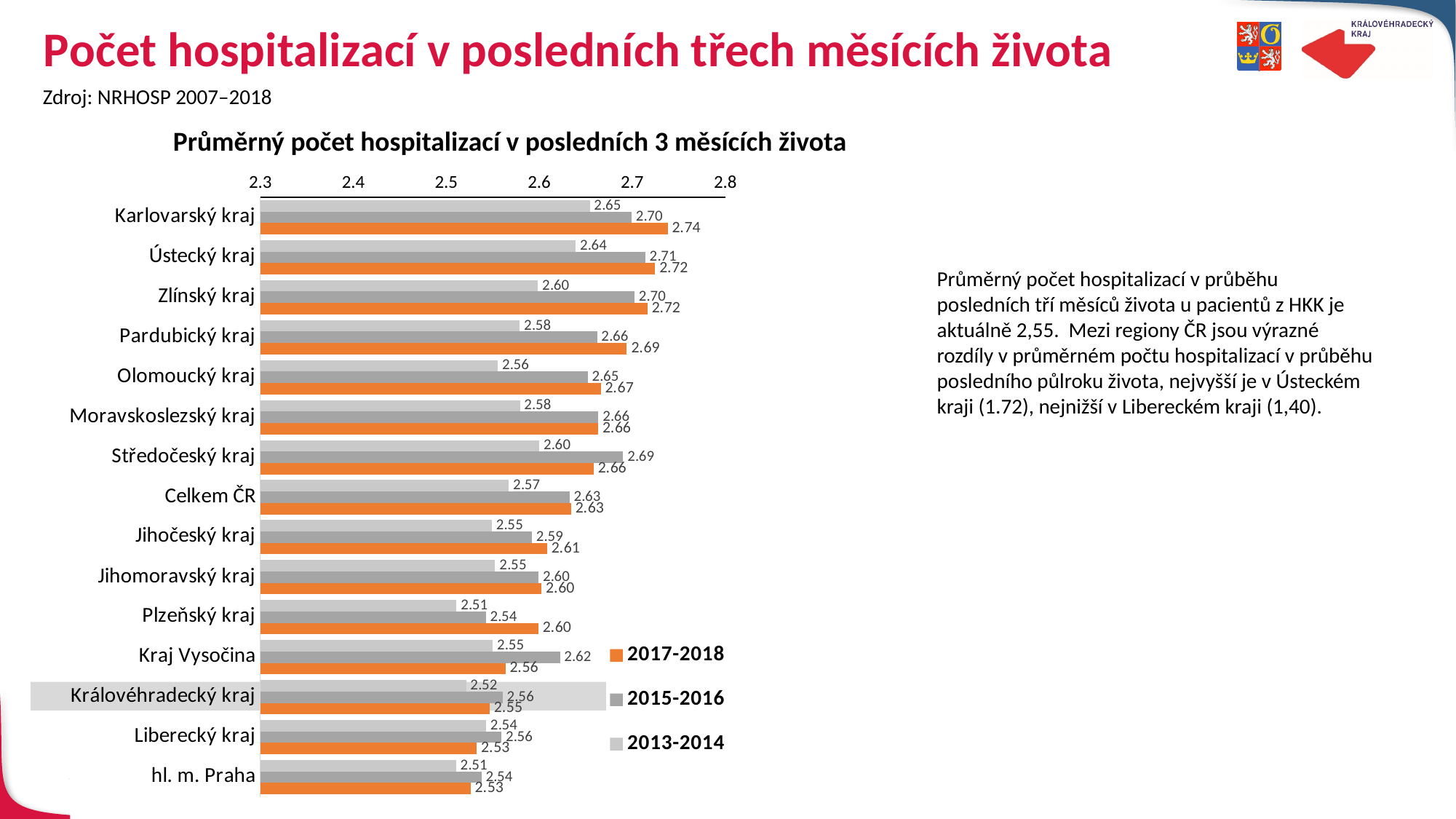
What is the difference between the 2017-2018 and 2013-2014 values for Karlovarský kraj? 0.09 How many regions (categories) are shown on the chart? 15 What is the value for Celkem ČR in the 2015-2016 series? 2.63 What is the value for Královéhradecký kraj in the 2017-2018 series? 2.55 What kind of chart is shown on the slide? Bar chart What is the difference between the 2017-2018 and 2015-2016 values for Plzeňský kraj? 0.06 Which series is shown in orange according to the legend? 2017-2018 Which region has the highest value in the 2017-2018 series? Karlovarský kraj For Kraj Vysočina, which is larger: the 2015-2016 value or the 2017-2018 value? 2015-2016 How many series does the legend list? 3 What is the value for Karlovarský kraj in the 2013-2014 series? 2.65 Which region has the highest value in the 2015-2016 series? Ústecký kraj